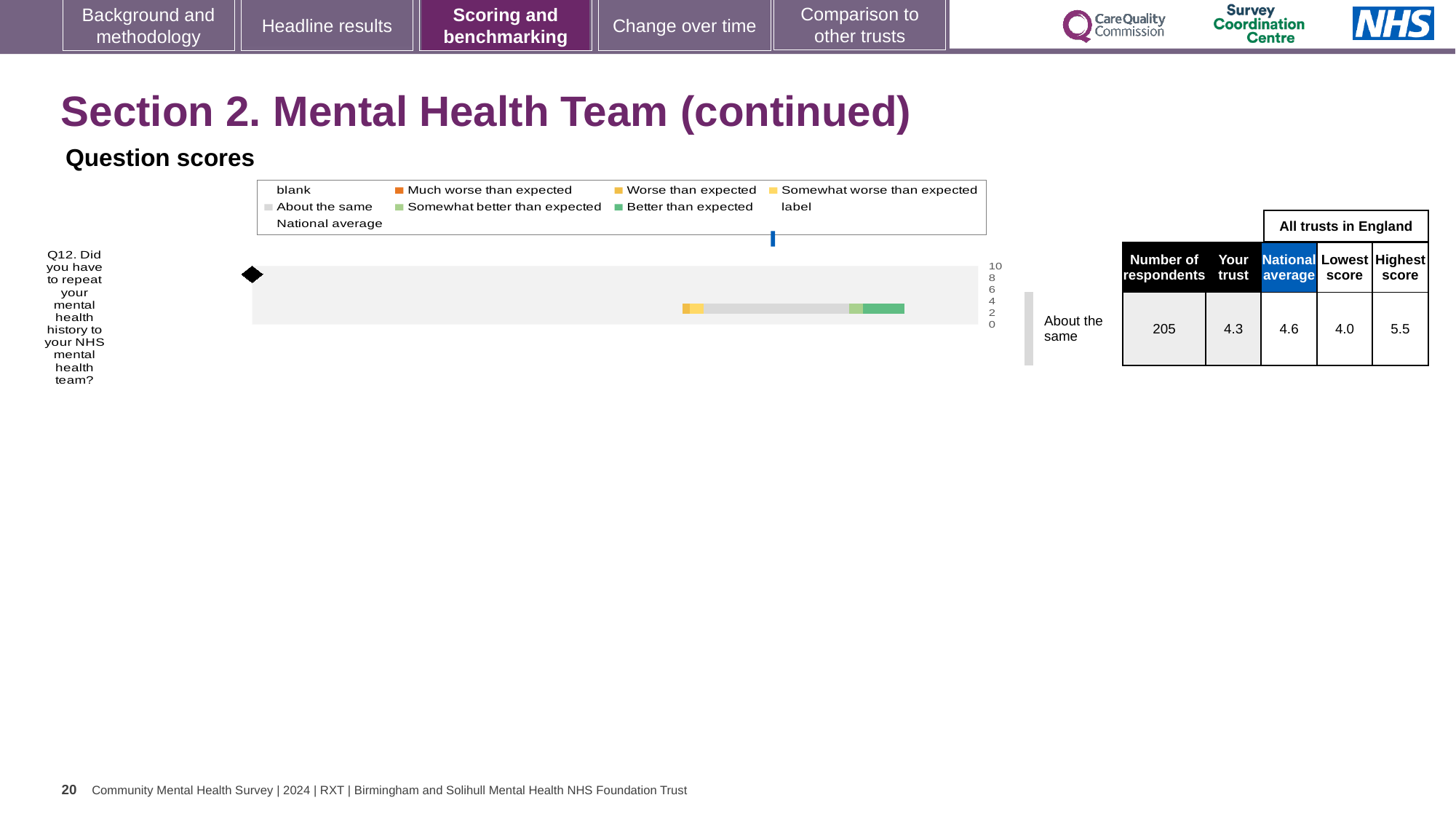
Which benchmarking category is the trust's Q12 score placed in? About the same What is the lowest score among all trusts in England for Q12? 4.0 How many respondents answered Q12? 205 What is the 'Your trust' score for Q12? 4.3 What is the difference between the national average and the trust's score for Q12? 0.3 What kind of chart is used to show the Q12 benchmarking result? Bar chart Which legend entry is shown in dark green? Better than expected How many survey questions are plotted on the chart? 1 What is the highest score among all trusts in England for Q12? 5.5 What is the national average score for Q12? 4.6 What is the difference between the highest and lowest trust scores for Q12? 1.5 Which is larger for Q12, the trust's score or the national average? National average